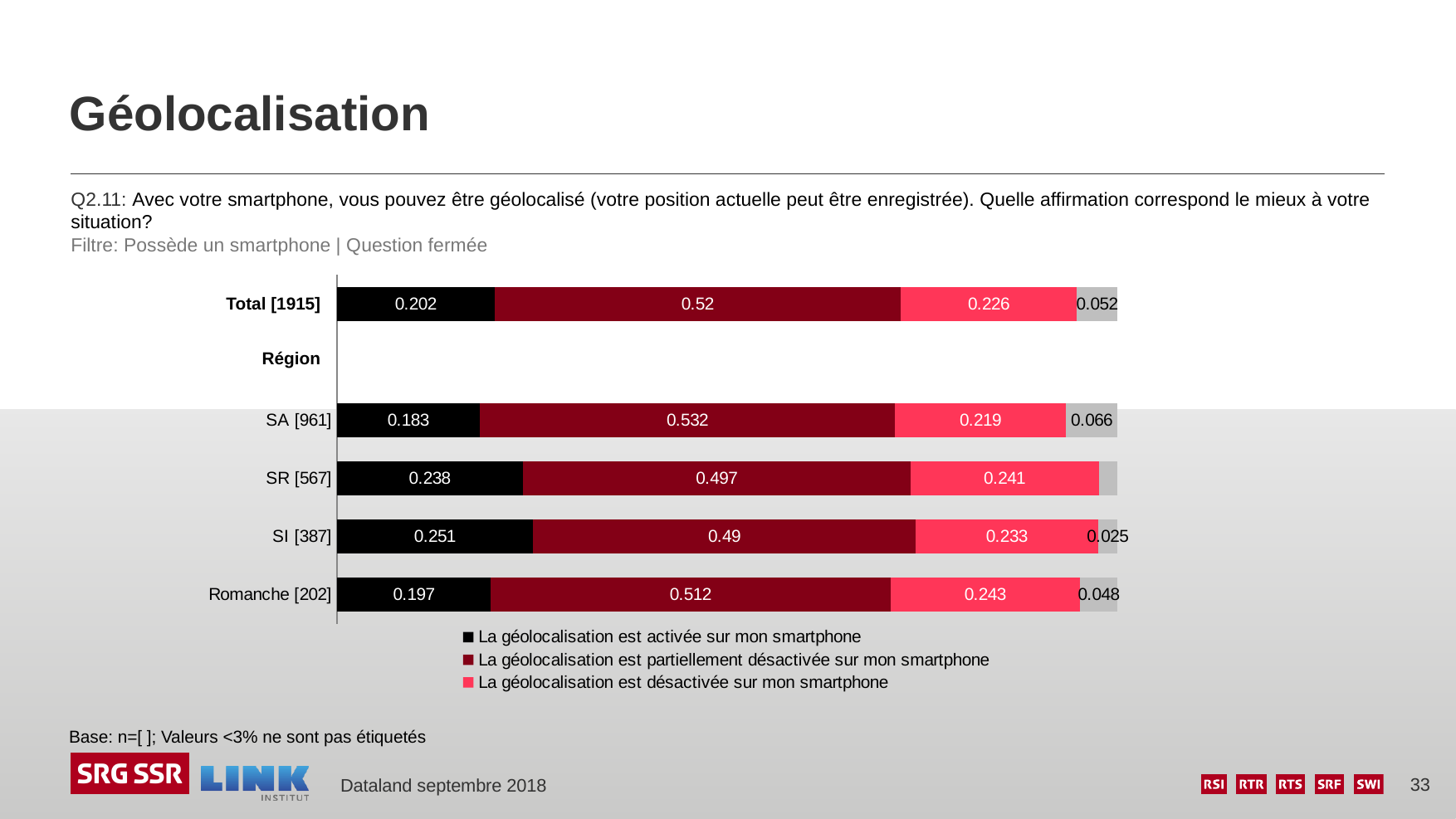
What kind of chart is shown on the slide? Stacked bar chart What is the difference between the 'activée' values for SI [387] and SA [961]? 0.068 How many series does the legend list? 3 Which category has the lowest value for 'La géolocalisation est activée sur mon smartphone'? SA [961] What is the value for 'La géolocalisation est désactivée sur mon smartphone' for Romanche [202]? 0.243 What colour represents 'La géolocalisation est désactivée sur mon smartphone' in the legend? Pink Which category has the highest value for 'La géolocalisation est activée sur mon smartphone'? SI [387] What is the value for 'La géolocalisation est activée sur mon smartphone' for Total [1915]? 0.202 How many categories (bars) are plotted in the chart? 5 What is the value for 'La géolocalisation est partiellement désactivée sur mon smartphone' for SR [567]? 0.497 What is the value for 'La géolocalisation est activée sur mon smartphone' for SI [387]? 0.251 Which is larger: the 'partiellement désactivée' value for SA [961] or for SI [387]? SA [961]